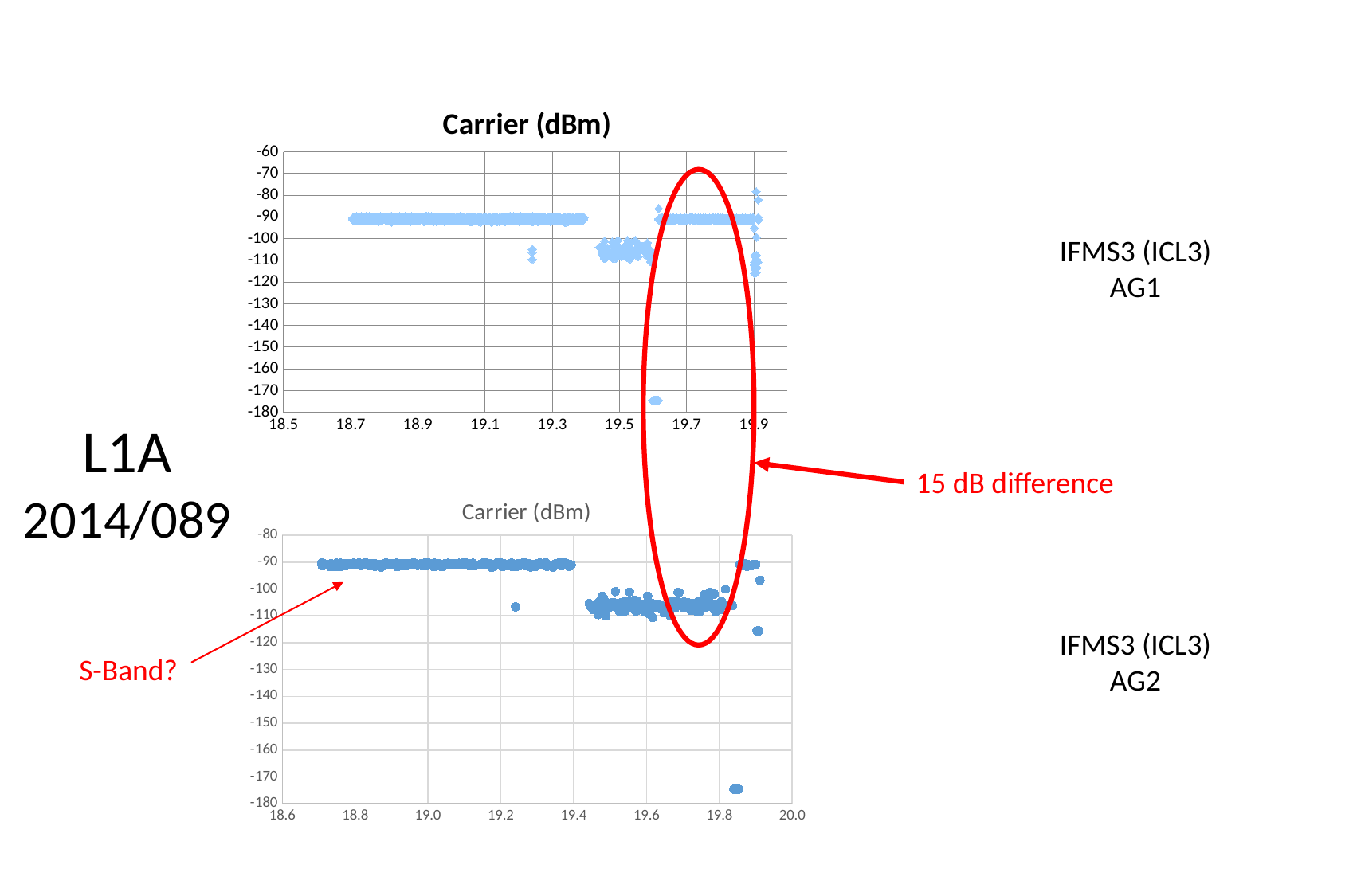
In the bottom chart, which has the higher carrier value: the points near x = 19.0 or the points near x = 19.6? points near x = 19.0 What kind of chart is the top chart on the slide? scatter chart In the top chart, is the value of the points near x = 19.0 greater or less than -100? greater How many charts are shown on the slide? 2 What kind of chart is the bottom chart on the slide? scatter chart In the bottom chart, do the carrier values rise or fall going from x = 19.0 to x = 19.6? fall In the bottom chart, is the value of the points near x = 19.0 greater or less than -100? greater In the bottom chart, is the lowest point (near x = 19.84) greater or less than -170? less What is the title of the top chart? Carrier (dBm)